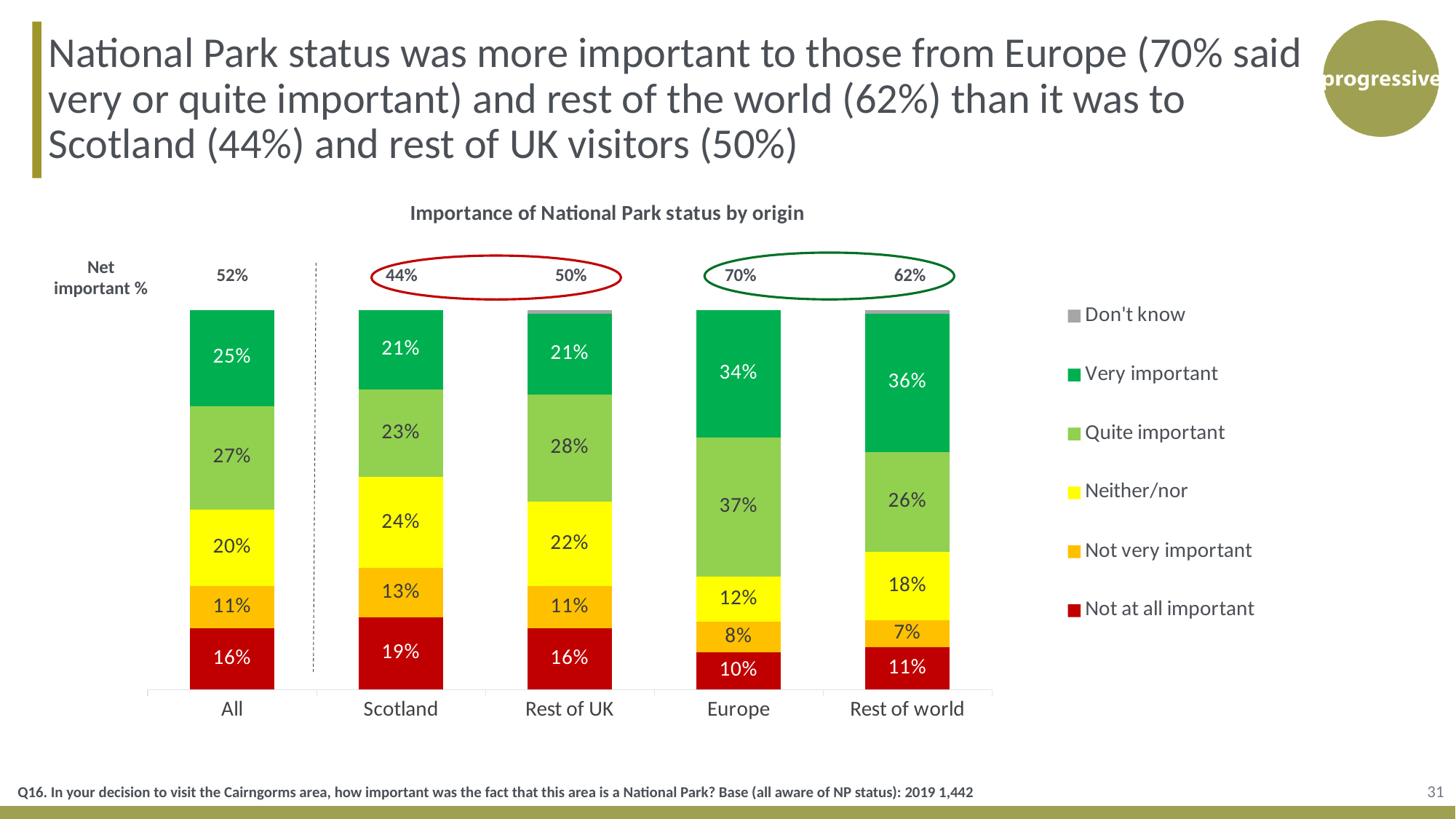
What is the 'Not at all important' value for Scotland? 19% Which origin has the highest 'Very important' value? Rest of world What is the Net important % shown for Rest of world? 62% What is the 'Quite important' value for Rest of UK? 28% Which is larger, the 'Quite important' value for Europe or for All? Europe What is the title of the chart? Importance of National Park status by origin How many series does the legend list? 6 How many origin categories are shown on the x axis? 5 What type of chart is shown on the slide? Stacked bar chart What is the difference between the 'Neither/nor' values for Scotland and Europe? 12% What is the 'Very important' value for Europe? 34% Which origin has the lowest 'Not very important' value? Rest of world